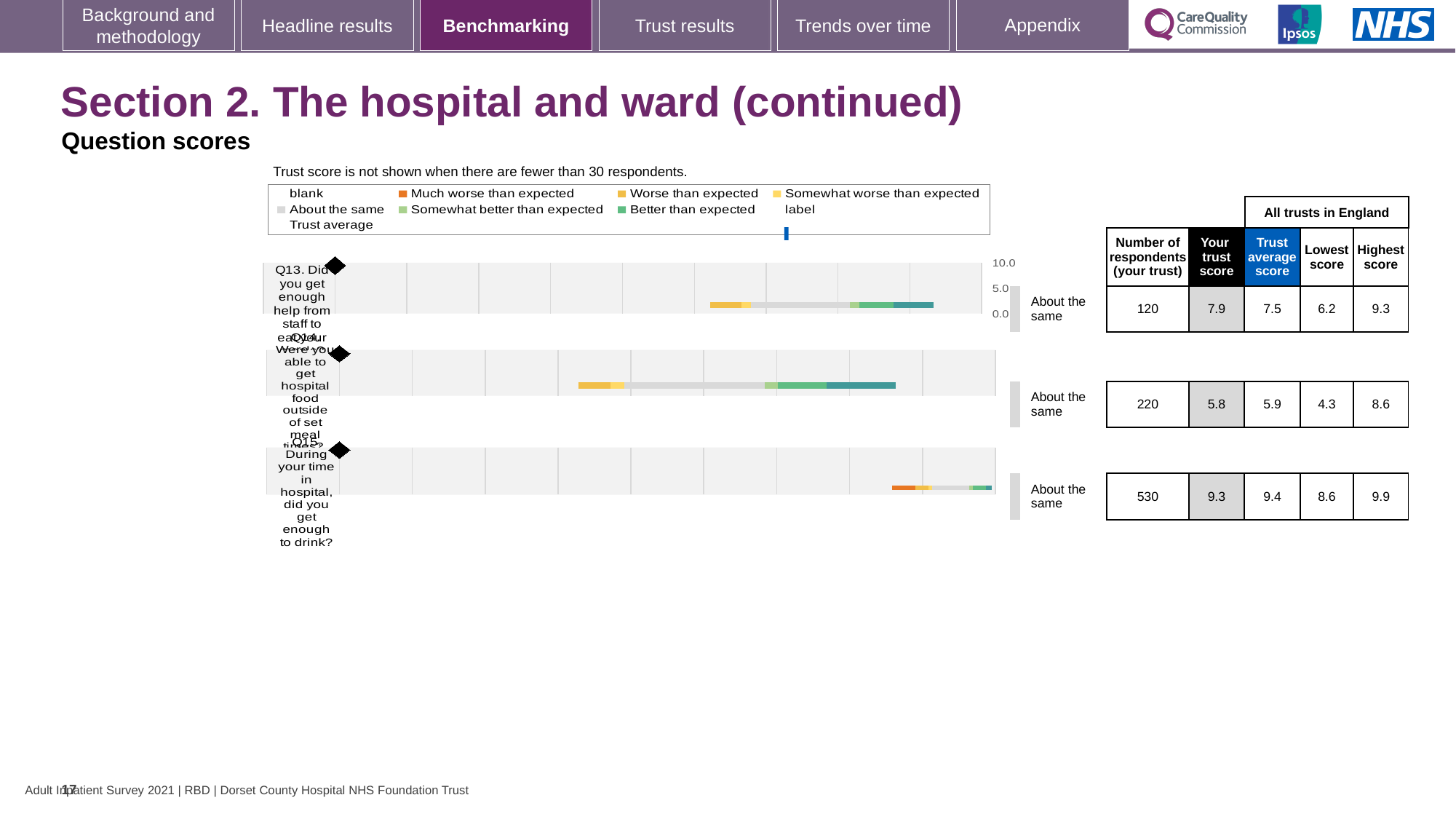
Which question has the largest number of respondents from your trust? Q15 What is the 'Your trust score' value for Q13 (Did you get enough help from staff to eat your meals?)? 7.9 How many respondents from your trust answered Q15 (did you get enough to drink?)? 530 What is the lowest score across all trusts in England for Q14? 4.3 What is the highest score across all trusts in England for Q15? 9.9 What is the difference between your trust score and the trust average score for Q13? 0.4 What benchmark category is shown next to each of the three questions? About the same What is the trust average score for Q14 (Were you able to get hospital food outside of set meal times?)? 5.9 What kind of chart is used to show the question scores on this slide? bar chart How many questions are plotted in the chart? 3 For Q15, which is larger: your trust score or the trust average score? Trust average score Which question has the lowest 'Your trust score'? Q14